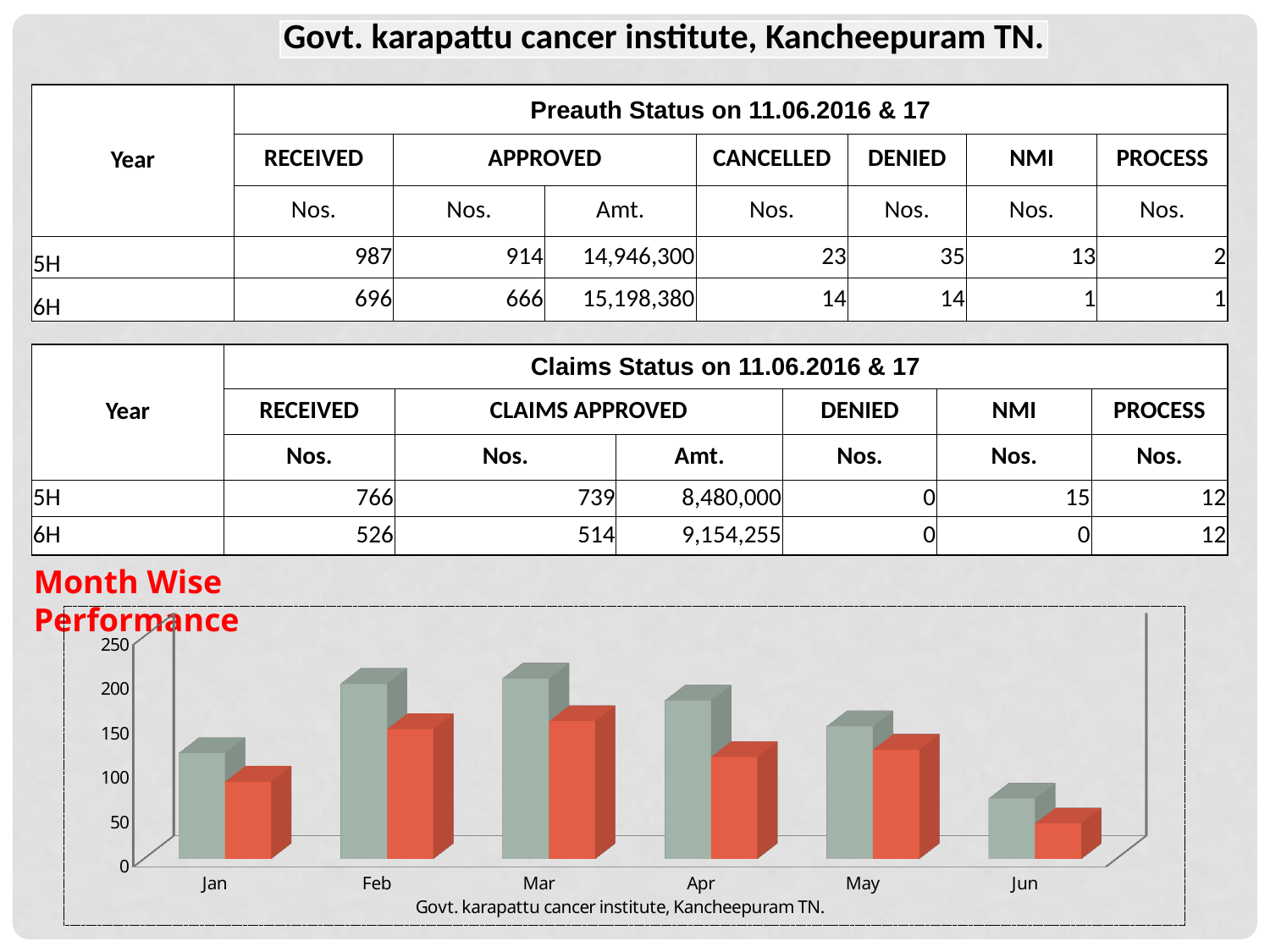
In the Month Wise Performance chart, is the grey bar for Jun greater or less than 100? less What kind of chart is shown under the heading 'Month Wise Performance'? bar chart In the Month Wise Performance chart, is the red bar for Apr greater or less than 150? less How many bars are plotted for each month in the Month Wise Performance chart? 2 What text appears below the month labels on the x axis of the Month Wise Performance chart? Govt. karapattu cancer institute, Kancheepuram TN. In the Month Wise Performance chart, which month has the lowest red bar? Jun In the Month Wise Performance chart, which month has the lowest grey bar? Jun In the Month Wise Performance chart, is the grey bar for Feb greater or less than 150? greater In the Month Wise Performance chart, which is larger for Mar: the grey bar or the red bar? the grey bar In the Month Wise Performance chart, do the grey bars rise or fall from Mar to Jun? fall How many months are shown on the x axis of the Month Wise Performance chart? 6